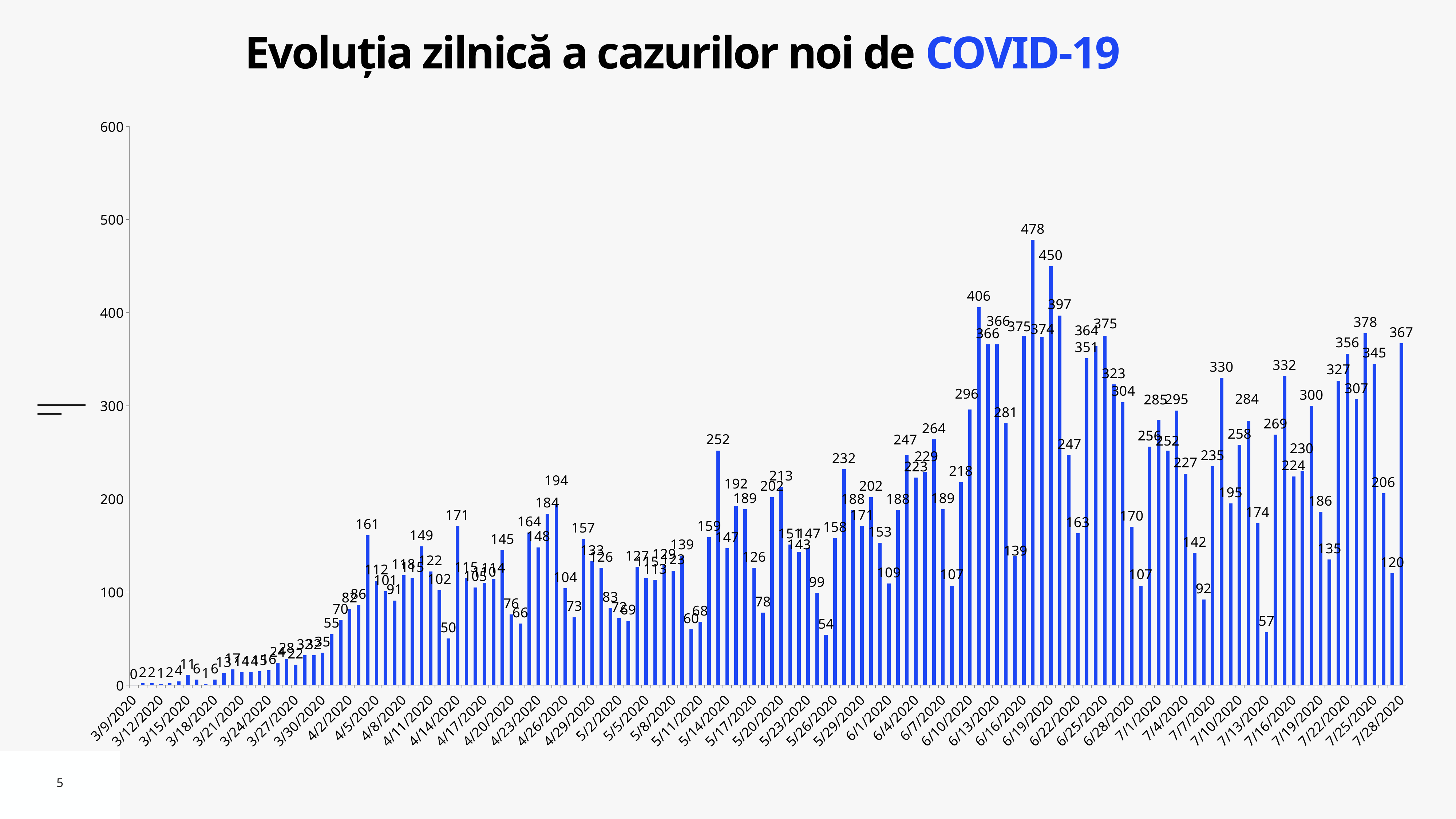
Do the daily values generally rise or fall from March to July 2020? rise What colour are the bars in the chart? blue What is the title of the chart? Evoluția zilnică a cazurilor noi de COVID-19 Is the value for 7/28/2020 greater or less than 300? greater Which is larger, the peak value of 478 or the neighbouring peak of 450? 478 What is the highest daily value shown in the chart? 478 What is the difference between the two highest values, 478 and 450? 28 What is the value for the first date, 3/9/2020? 0 What is the difference between the value 406 and the final value of 367? 39 Is the highest value in the chart greater or less than 500? less What kind of chart is shown on the slide? bar chart What is the value for the last date, 7/28/2020? 367